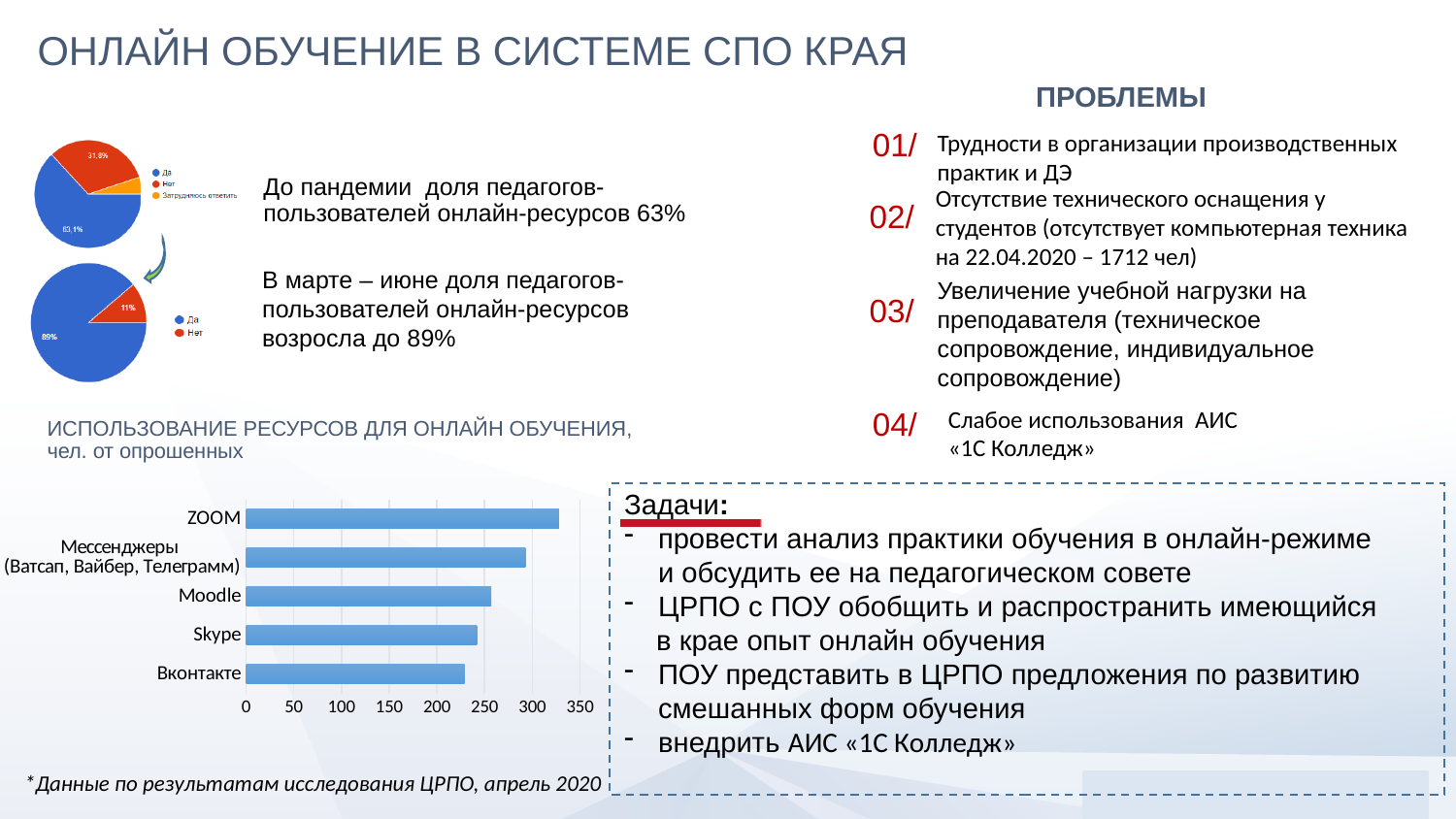
In the bar chart 'ИСПОЛЬЗОВАНИЕ РЕСУРСОВ ДЛЯ ОНЛАЙН ОБУЧЕНИЯ', which has a larger value, ZOOM or Moodle? ZOOM What kind of chart is the chart titled 'ИСПОЛЬЗОВАНИЕ РЕСУРСОВ ДЛЯ ОНЛАЙН ОБУЧЕНИЯ'? Bar chart In the upper pie chart on the left of the slide, what share is labelled for 'Да'? 63,1% In the bar chart 'ИСПОЛЬЗОВАНИЕ РЕСУРСОВ ДЛЯ ОНЛАЙН ОБУЧЕНИЯ', is the value for Moodle greater or less than 300? less How many categories are shown in the bar chart 'ИСПОЛЬЗОВАНИЕ РЕСУРСОВ ДЛЯ ОНЛАЙН ОБУЧЕНИЯ'? 5 In the bar chart 'ИСПОЛЬЗОВАНИЕ РЕСУРСОВ ДЛЯ ОНЛАЙН ОБУЧЕНИЯ', is the value for ZOOM greater or less than 300? greater In the bar chart 'ИСПОЛЬЗОВАНИЕ РЕСУРСОВ ДЛЯ ОНЛАЙН ОБУЧЕНИЯ', do the values increase or decrease going from ZOOM at the top to Вконтакте at the bottom? decrease In the bar chart 'ИСПОЛЬЗОВАНИЕ РЕСУРСОВ ДЛЯ ОНЛАЙН ОБУЧЕНИЯ', which has a larger value, Мессенджеры or Skype? Мессенджеры In the bar chart 'ИСПОЛЬЗОВАНИЕ РЕСУРСОВ ДЛЯ ОНЛАЙН ОБУЧЕНИЯ', which resource has the highest value? ZOOM How many entries does the legend of the lower pie chart on the left of the slide list? 2 In the lower pie chart on the left of the slide, what share is labelled for 'Нет'? 11% In the bar chart 'ИСПОЛЬЗОВАНИЕ РЕСУРСОВ ДЛЯ ОНЛАЙН ОБУЧЕНИЯ', is the value for Вконтакте greater or less than 250? less